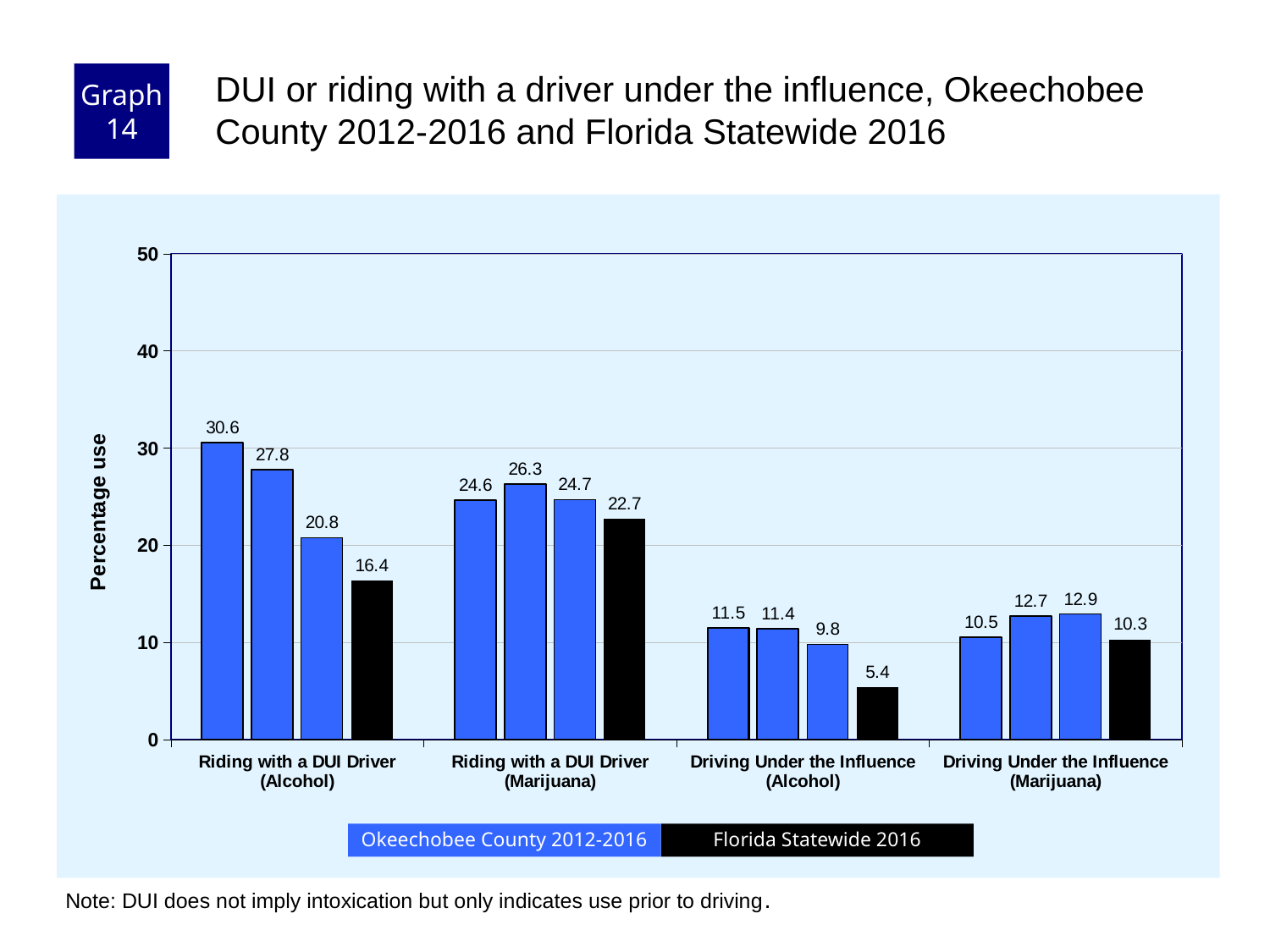
How many categories are shown on the x axis? 4 What is the Florida Statewide 2016 value for Riding with a DUI Driver (Alcohol)? 16.4 Which category has the lowest Florida Statewide 2016 value? Driving Under the Influence (Alcohol) What is the Florida Statewide 2016 value for Driving Under the Influence (Alcohol)? 5.4 Which category has the highest Florida Statewide 2016 value? Riding with a DUI Driver (Marijuana) Is the Florida Statewide 2016 value for Riding with a DUI Driver (Marijuana) greater or less than 20? greater What kind of chart is shown on the slide? Bar chart How many series does the legend list? 2 What is the difference between the Florida Statewide 2016 values for Riding with a DUI Driver (Marijuana) and Riding with a DUI Driver (Alcohol)? 6.3 Which is larger: the Florida Statewide 2016 value for Riding with a DUI Driver (Alcohol) or for Driving Under the Influence (Marijuana)? Riding with a DUI Driver (Alcohol) What is the value of the first (leftmost) Okeechobee County bar for Riding with a DUI Driver (Alcohol)? 30.6 What is the Florida Statewide 2016 value for Driving Under the Influence (Marijuana)? 10.3